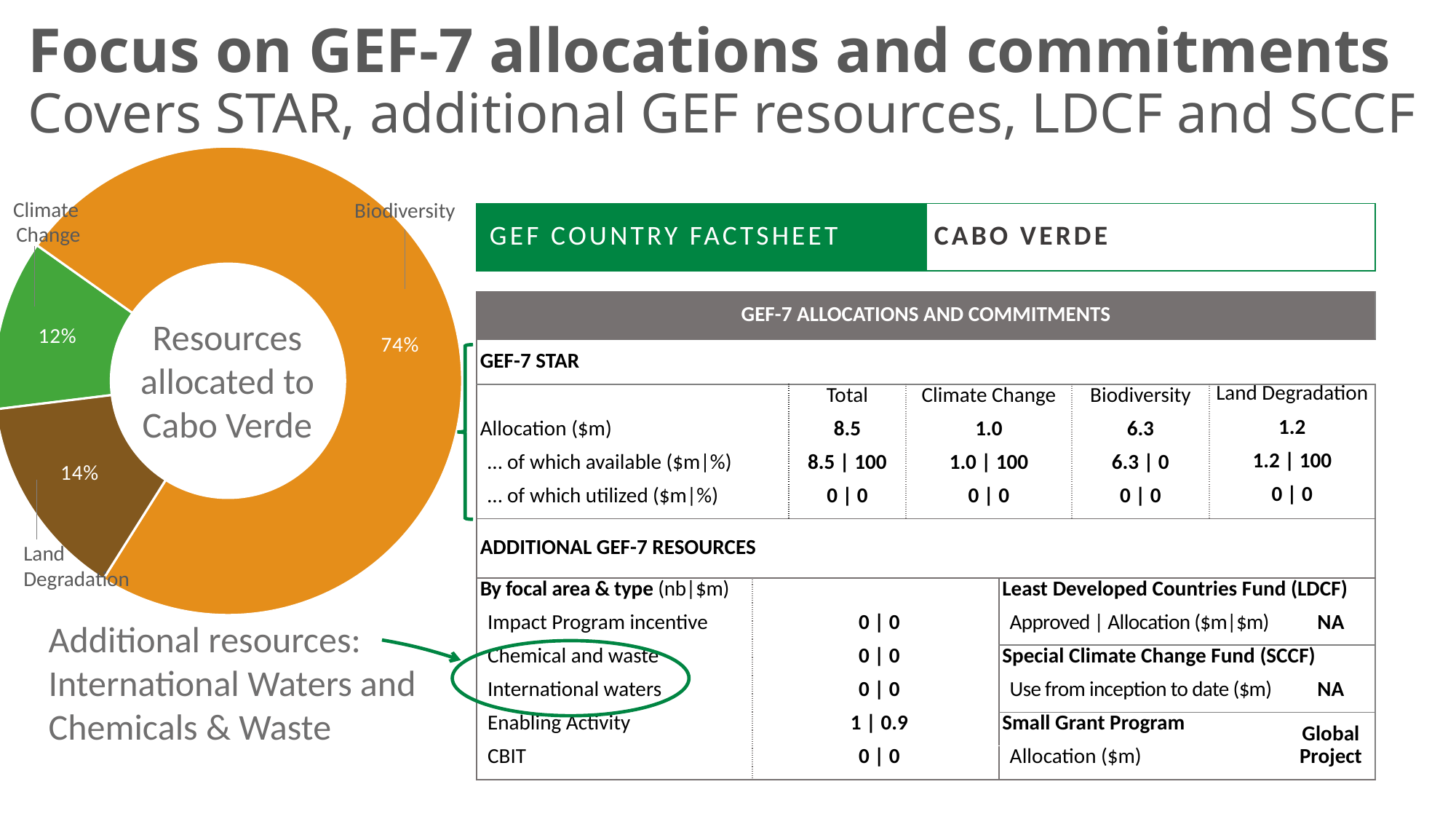
What kind of chart is shown on the left of the slide? Doughnut chart What text appears in the centre of the doughnut chart? Resources allocated to Cabo Verde How many slices does the doughnut chart have? 3 What is the difference in percentage points between the Land Degradation and Climate Change slices? 2 What share of the doughnut chart does Land Degradation represent? 14% Which focal area has the largest slice in the doughnut chart? Biodiversity What share of the doughnut chart does Climate Change represent? 12% Which focal area has the smallest slice in the doughnut chart? Climate Change What is the difference in percentage points between the Biodiversity and Land Degradation slices? 60 What share of the doughnut chart does Biodiversity represent? 74% Which slice is larger in the doughnut chart, Land Degradation or Climate Change? Land Degradation What colour is the Biodiversity slice in the doughnut chart? Orange